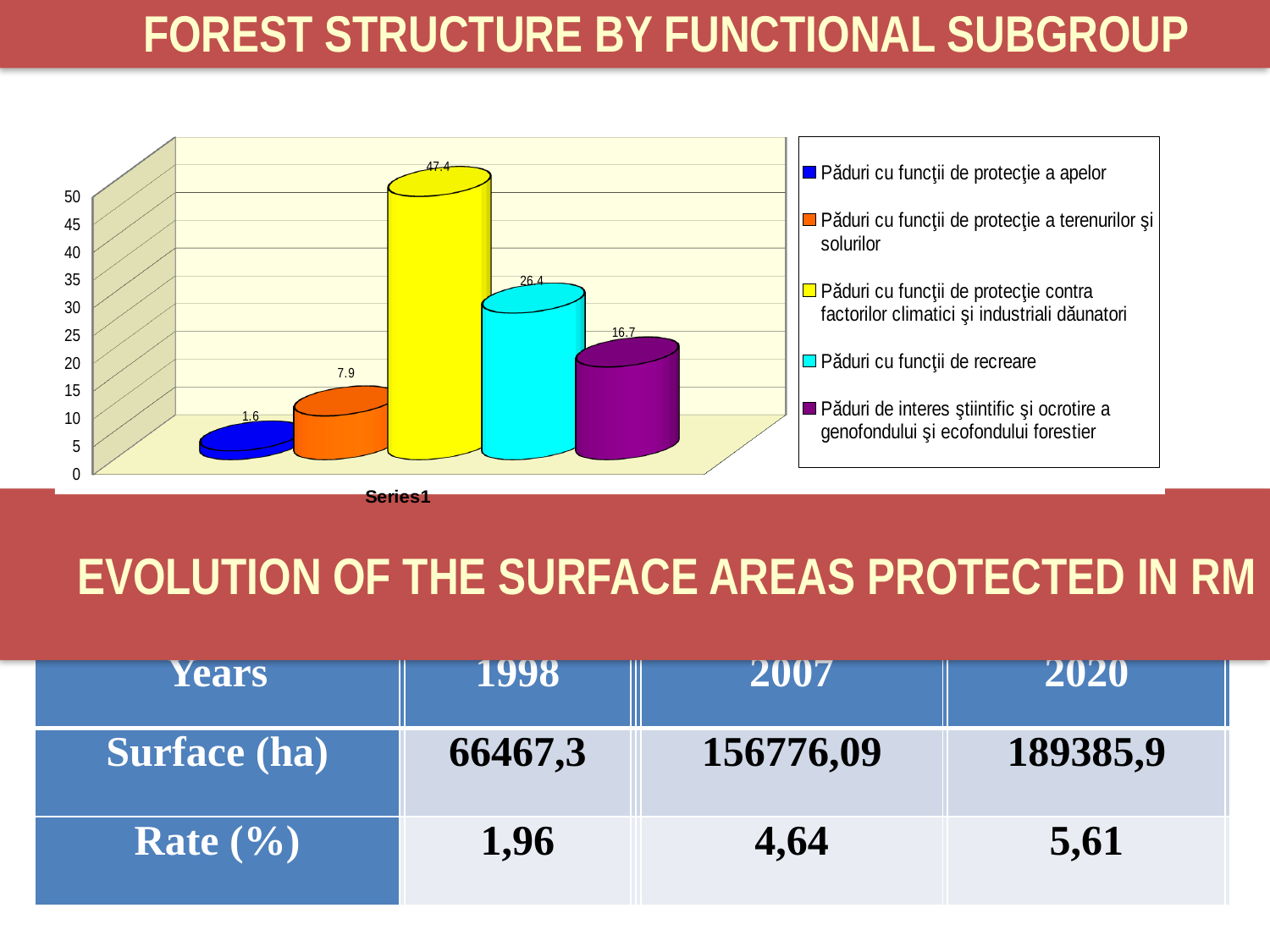
What value is shown for "Păduri cu funcţii de protecţie a apelor"? 1.6 Which is larger: the value for "Păduri cu funcţii de protecţie a terenurilor şi solurilor" or the value for "Păduri cu funcţii de recreare"? Păduri cu funcţii de recreare Which category has the highest value in the chart? Păduri cu funcţii de protecţie contra factorilor climatici şi industriali dăunatori What kind of chart is shown on the slide? bar chart What value is shown for "Păduri cu funcţii de recreare"? 26.4 Which category has the lowest value in the chart? Păduri cu funcţii de protecţie a apelor Is the value for "Păduri cu funcţii de protecţie contra factorilor climatici şi industriali dăunatori" greater or less than 40? greater What colour is the bar for "Păduri cu funcţii de protecţie a terenurilor şi solurilor"? orange What value is shown for "Păduri de interes ştiintific şi ocrotire a genofondului şi ecofondului forestier"? 16.7 What value is shown for "Păduri cu funcţii de protecţie contra factorilor climatici şi industriali dăunatori"? 47.4 How many bars are plotted in the chart? 5 What is the difference between the values for "Păduri cu funcţii de recreare" and "Păduri de interes ştiintific şi ocrotire a genofondului şi ecofondului forestier"? 9.7